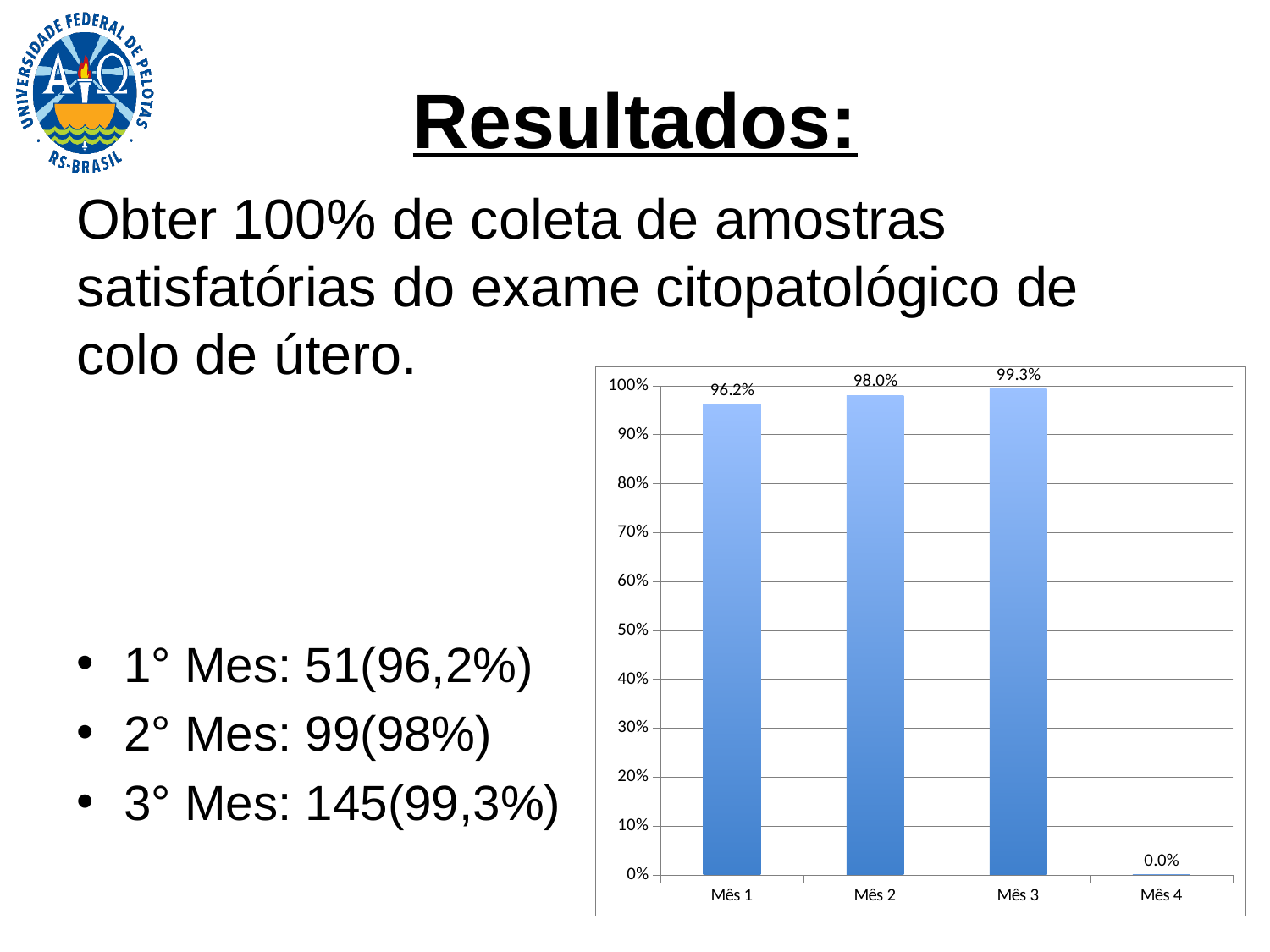
What kind of chart is shown on the slide? bar chart Which category has the highest value? Mês 3 Which is larger, the value for Mês 2 or the value for Mês 1? Mês 2 How many categories are shown on the x axis? 4 What is the difference between the values for Mês 3 and Mês 1? 3.1% What is the value for Mês 3? 99.3% Do the values rise or fall from Mês 1 to Mês 3? rise What is the value for Mês 2? 98.0% What is the value for Mês 1? 96.2% What is the value for Mês 4? 0.0% Is the value for Mês 1 greater or less than 90%? greater Which category has the lowest value? Mês 4